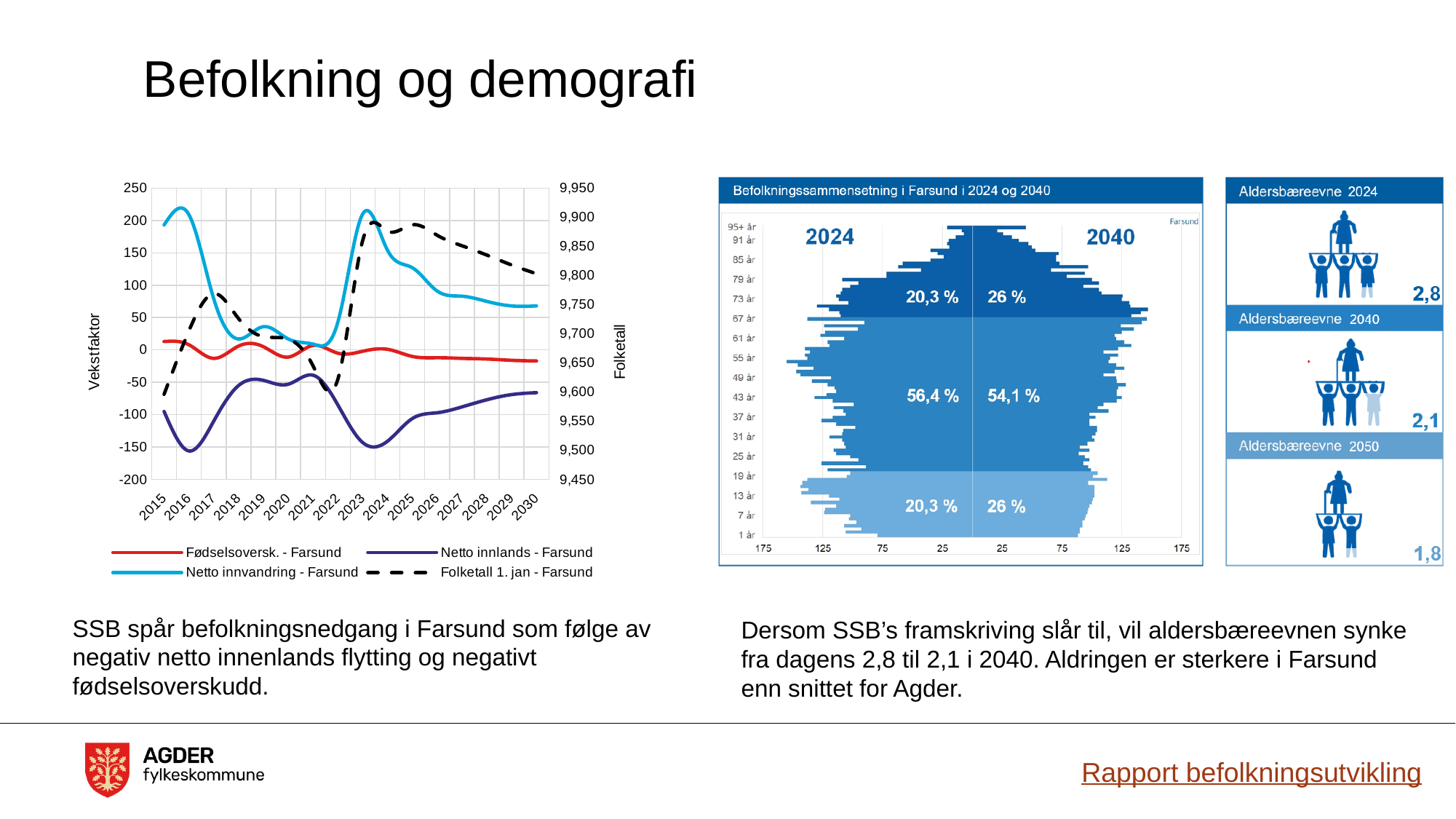
In the chart 'Befolkningssammensetning i Farsund i 2024 og 2040', what share of the population is in the oldest age group in 2024? 20,3 % In the left line chart, is the value for Netto innvandring - Farsund in 2016 greater or less than 200? greater In the left line chart, does Netto innlands - Farsund rise or fall from 2024 to 2030? rise How many years are shown on the x axis of the left line chart? 16 In the chart 'Befolkningssammensetning i Farsund i 2024 og 2040', which year has the larger share in the oldest age group, 2024 or 2040? 2040 In the left line chart, is the value for Netto innlands - Farsund in 2024 greater or less than -100? less In the left line chart, is the value for Folketall 1. jan - Farsund in 2025 greater or less than 9,850? greater What kind of chart is the chart on the left of the slide? line chart How many series does the legend of the left line chart list? 4 In the left line chart, does Netto innvandring - Farsund rise or fall from 2024 to 2030? fall In the chart 'Befolkningssammensetning i Farsund i 2024 og 2040', what share of the population is in the middle age group in 2040? 54,1 % In the Aldersbæreevne panels on the right, what is the value for 2050? 1,8